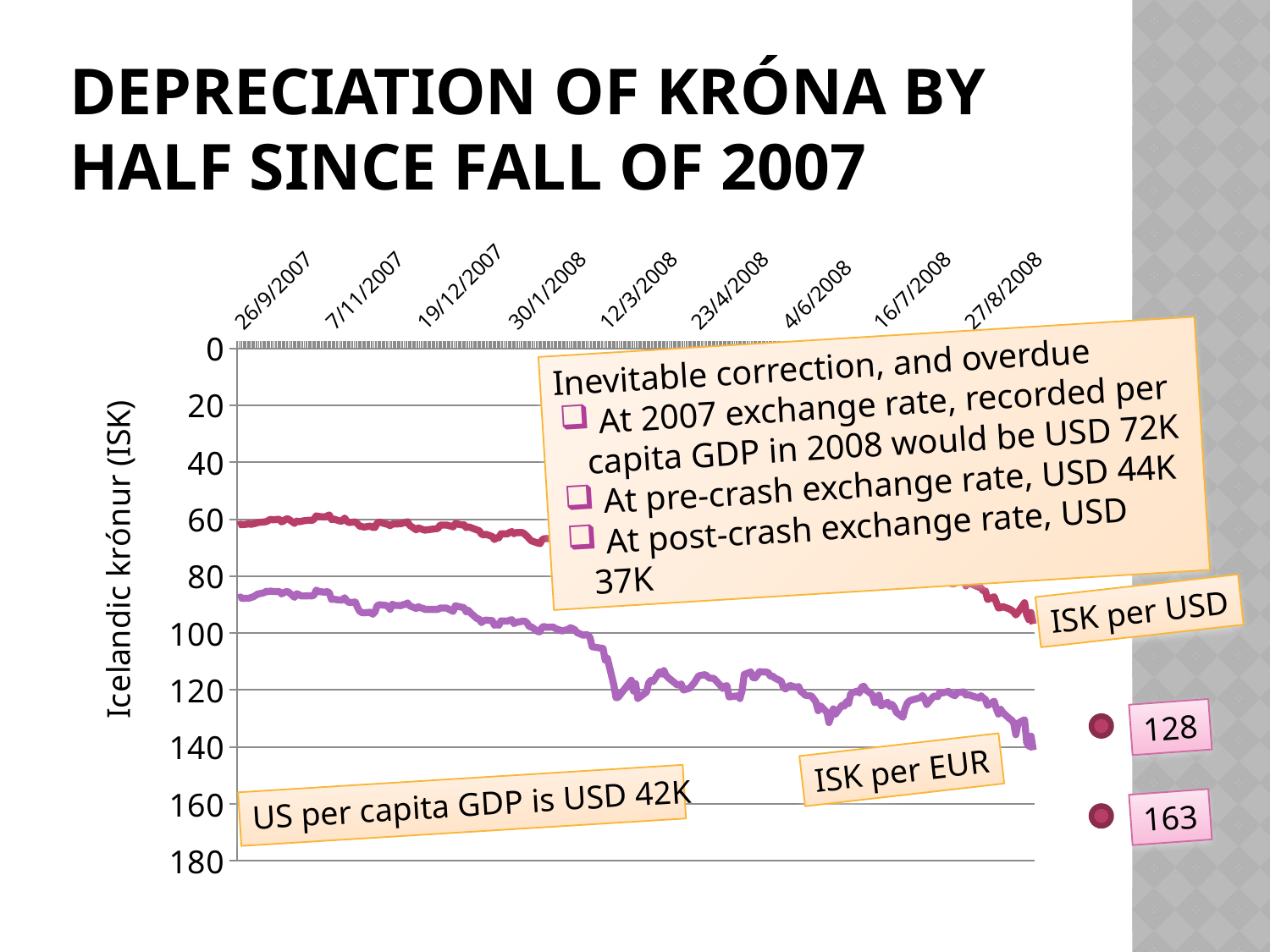
Is the ISK per USD value at 26/9/2007 greater or less than 40? greater What kind of chart is shown on the slide? line chart Do the ISK per EUR values rise or fall from 26/9/2007 to 27/8/2008? rise At 26/9/2007, which series has the larger value, ISK per USD or ISK per EUR? ISK per EUR What are the names of the two series plotted on the chart? ISK per USD and ISK per EUR What is the title of the vertical axis of the chart? Icelandic krónur (ISK) Is the ISK per USD value at 26/9/2007 greater or less than 80? less Is the ISK per EUR value at 26/9/2007 greater or less than 80? greater How many date labels are shown along the x axis of the chart? 9 How many data series are plotted on the chart? 2